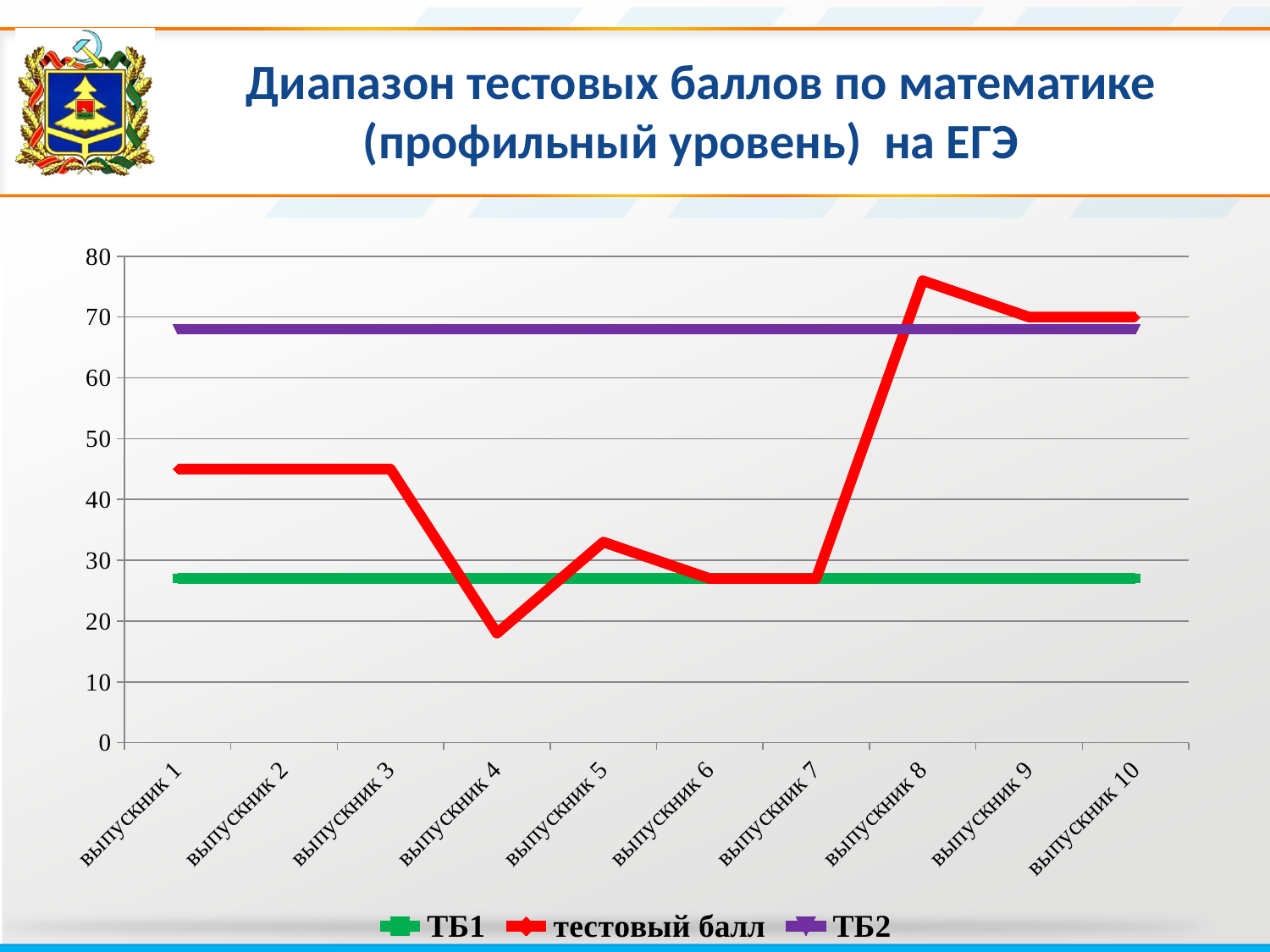
What colour is the тестовый балл line? red Which has the larger тестовый балл, выпускник 5 or выпускник 4? выпускник 5 Does the тестовый балл rise or fall from выпускник 7 to выпускник 8? rise How many series does the legend list? 3 Is the тестовый балл for выпускник 1 greater or less than 40? greater Is the тестовый балл for выпускник 4 greater or less than 20? less Is the ТБ1 line greater or less than 30? less Which выпускник has the highest тестовый балл? выпускник 8 Which выпускник has the lowest тестовый балл? выпускник 4 How many выпускник categories are shown on the x axis? 10 What kind of chart is shown on the slide? line chart